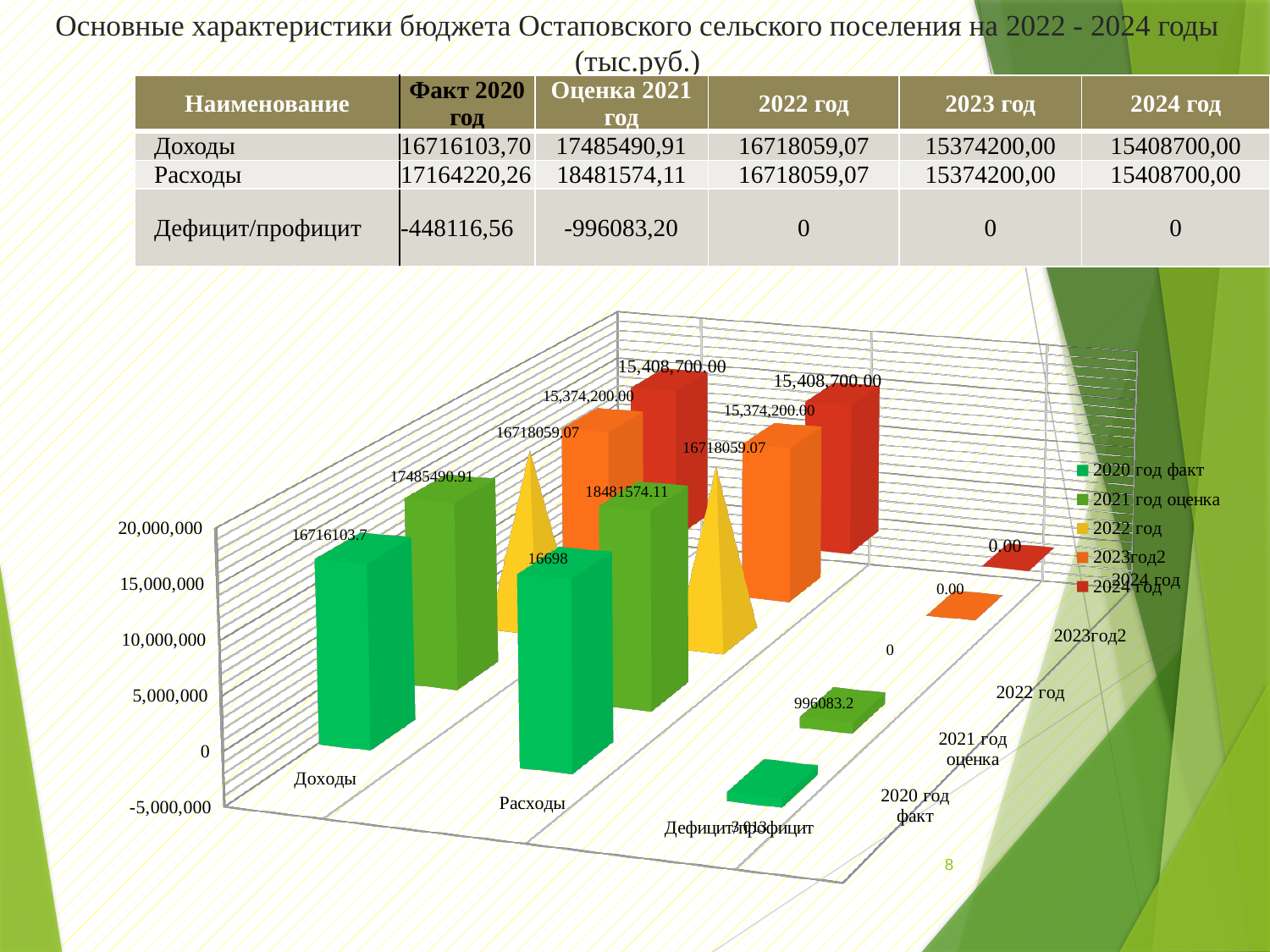
How many categories are shown along the chart's category axis? 3 What is the value for Дефицит/профицит in the 2021 год оценка series? 996083.2 What is the value for Расходы in the 2021 год оценка series? 18481574.11 Which is larger in the 2021 год оценка series: Доходы or Расходы? Расходы Is the value for Доходы in the 2020 год факт series greater or less than 15,000,000? greater What colour represents the 2024 год series in the chart? red What kind of chart is shown on the slide? bar chart What is the value for Доходы in the 2021 год оценка series? 17485490.91 How many series does the chart legend list? 5 What is the difference between Расходы and Доходы in the 2021 год оценка series? 996083.2 Which category has the highest value in the 2021 год оценка series? Расходы What is the value for Доходы in the 2020 год факт series? 16716103.7